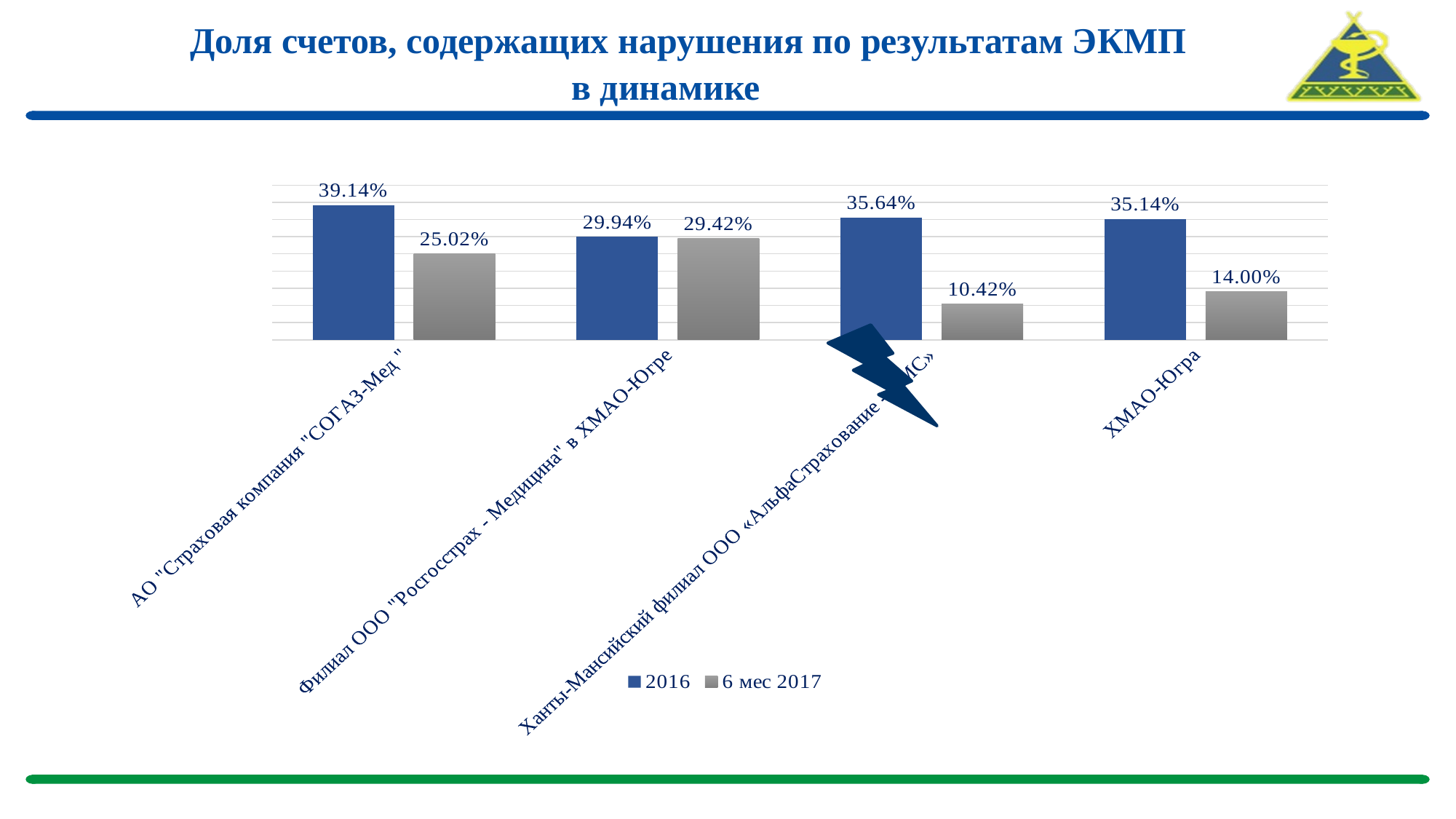
Which category has the lowest 6 мес 2017 value? Ханты-Мансийский филиал ООО «АльфаСтрахование» What is the difference between the 2016 and 6 мес 2017 values for ХМАО-Югра? 21.14% What kind of chart is shown on the slide? bar chart What are the two legend entries of the chart? 2016 and 6 мес 2017 What is the 6 мес 2017 value for Филиал ООО "Росгосстрах - Медицина" в ХМАО-Югре? 29.42% Which category has the highest 2016 value? АО "Страховая компания "СОГАЗ-Мед" What is the 6 мес 2017 value for ХМАО-Югра? 14.00% How many categories are shown on the x axis? 4 What is the 2016 value for АО "Страховая компания "СОГАЗ-Мед"? 39.14% Which is larger for АО "Страховая компания "СОГАЗ-Мед": the 2016 value or the 6 мес 2017 value? 2016 What is the 2016 value for the Ханты-Мансийский филиал ООО «АльфаСтрахование» category? 35.64% How many series does the legend list? 2